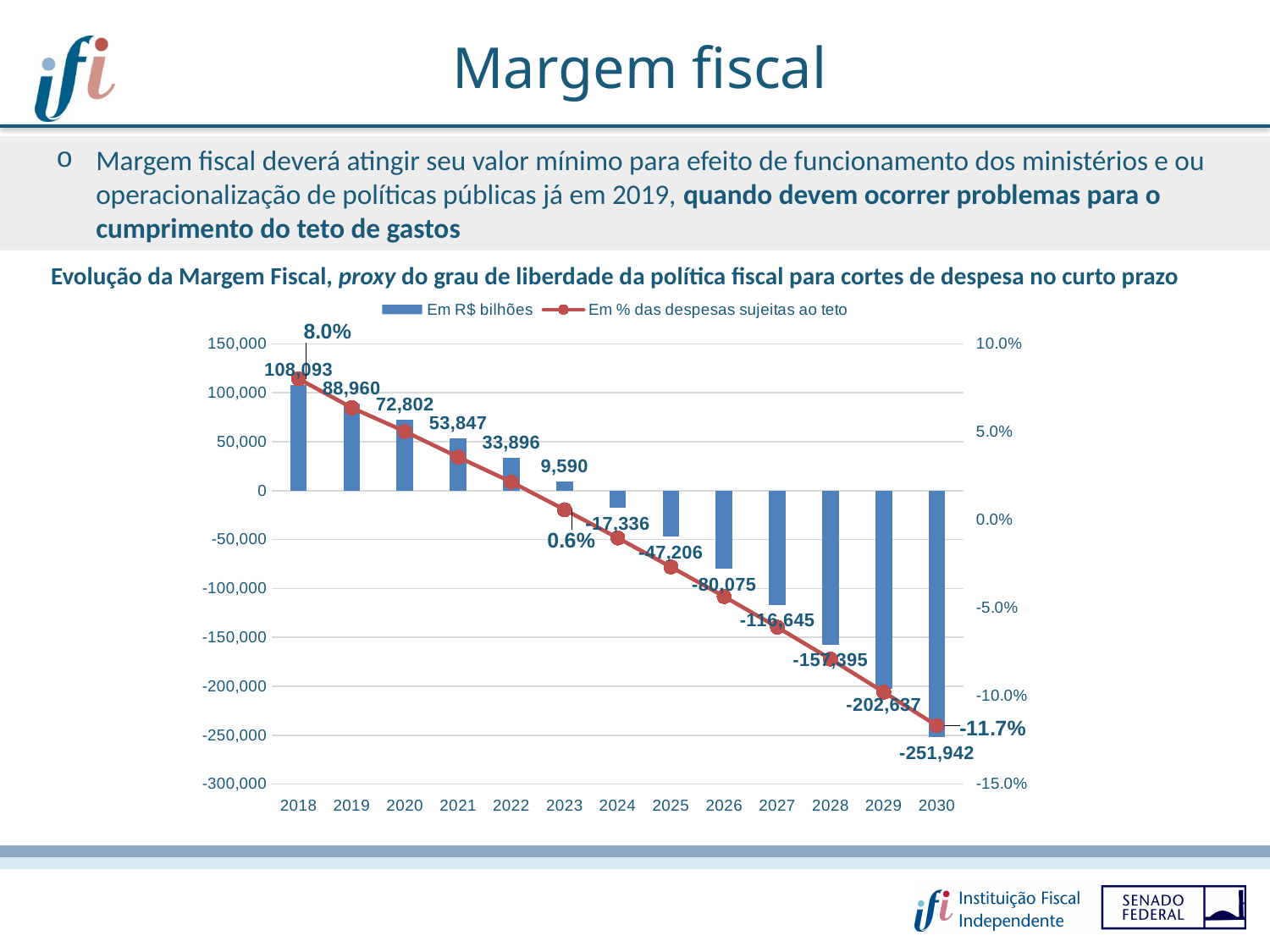
What is the value of the 'Em R$ bilhões' bar for 2030? -251,942 Which year has the lowest 'Em R$ bilhões' value? 2030 What value does the 'Em % das despesas sujeitas ao teto' line show for 2030? -11.7% Do the 'Em R$ bilhões' values rise or fall from 2018 to 2030? fall What value does the 'Em % das despesas sujeitas ao teto' line show for 2018? 8.0% What is the value of the 'Em R$ bilhões' bar for 2018? 108,093 Which year has a larger 'Em R$ bilhões' value, 2021 or 2022? 2021 What is the value of the 'Em R$ bilhões' bar for 2023? 9,590 How many series does the chart legend list? 2 Which year has the highest 'Em R$ bilhões' value? 2018 What is the difference between the 'Em R$ bilhões' values for 2018 and 2019? 19,133 How many years are shown on the x axis of the chart? 13